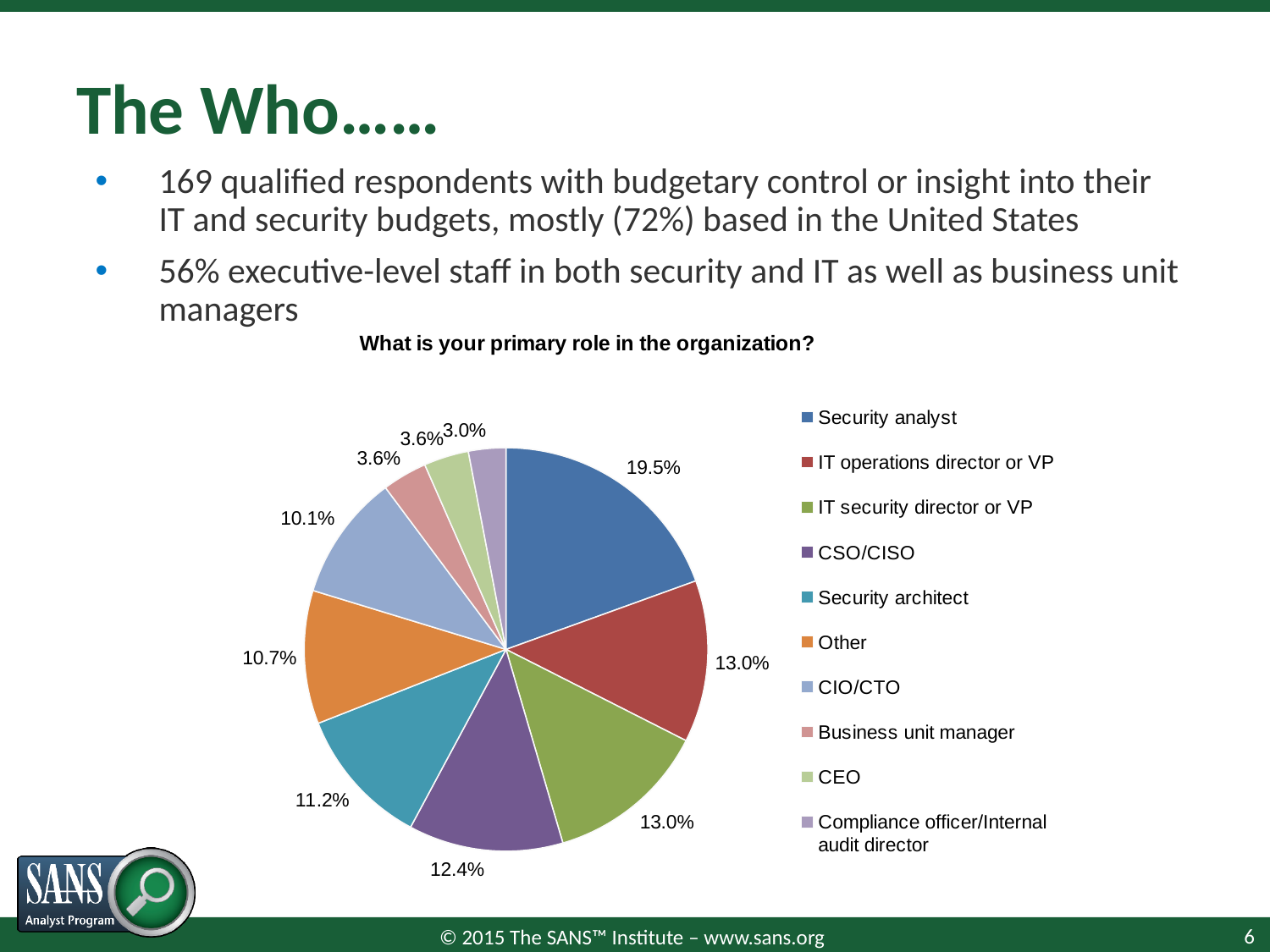
What is the difference in percentage points between Security analyst and CSO/CISO? 7.1 Which role has the smallest share of respondents? Compliance officer/Internal audit director What share of respondents are Security analysts? 19.5% What is the title of the chart? What is your primary role in the organization? Which is larger, the share for Other or the share for CIO/CTO? Other How many roles are listed in the chart legend? 10 What share of respondents selected CIO/CTO as their primary role? 10.1% What type of chart is shown on the slide? Pie chart What percentage of respondents are Compliance officer/Internal audit director? 3.0% Which role has the largest share of respondents? Security analyst What percentage of respondents are CSO/CISO? 12.4% What percentage of respondents are Security architects? 11.2%